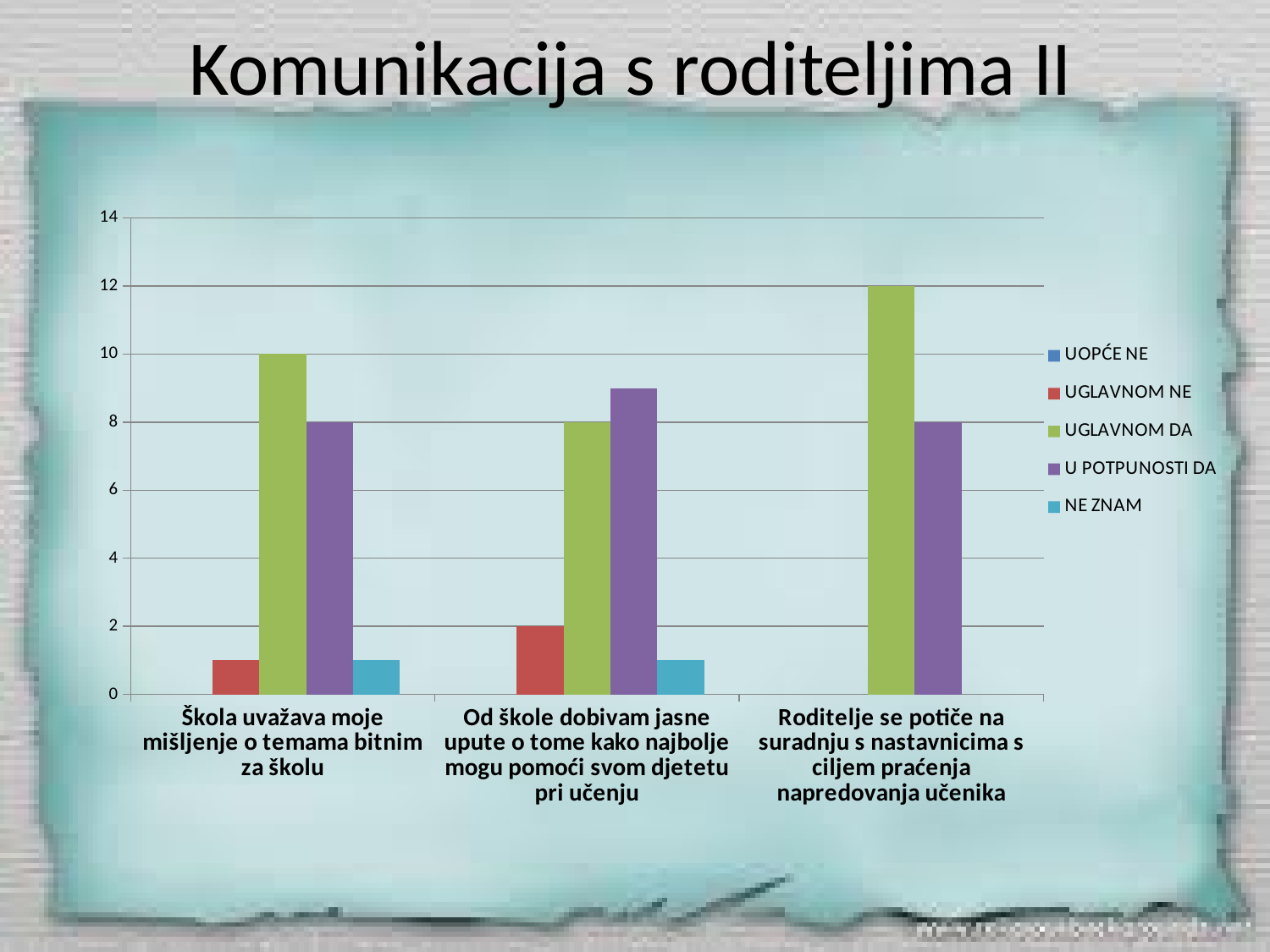
Is the value for NE ZNAM in the category 'Škola uvažava moje mišljenje o temama bitnim za školu' greater or less than 2? less What type of chart is shown on the slide? bar chart How many categories are shown on the x axis? 3 How many series does the legend list? 5 What is the title of the slide? Komunikacija s roditeljima II What is the difference between the UGLAVNOM DA and U POTPUNOSTI DA values in the category 'Roditelje se potiče na suradnju s nastavnicima s ciljem praćenja napredovanja učenika'? 4 What is the value for UGLAVNOM DA in the category 'Škola uvažava moje mišljenje o temama bitnim za školu'? 10 In the category 'Od škole dobivam jasne upute o tome kako najbolje mogu pomoći svom djetetu pri učenju', which is larger: UGLAVNOM DA or U POTPUNOSTI DA? U POTPUNOSTI DA What is the value for UGLAVNOM DA in the category 'Roditelje se potiče na suradnju s nastavnicima s ciljem praćenja napredovanja učenika'? 12 What is the value for U POTPUNOSTI DA in the category 'Škola uvažava moje mišljenje o temama bitnim za školu'? 8 What is the value for UGLAVNOM NE in the category 'Od škole dobivam jasne upute o tome kako najbolje mogu pomoći svom djetetu pri učenju'? 2 Which category has the highest UGLAVNOM DA value? Roditelje se potiče na suradnju s nastavnicima s ciljem praćenja napredovanja učenika